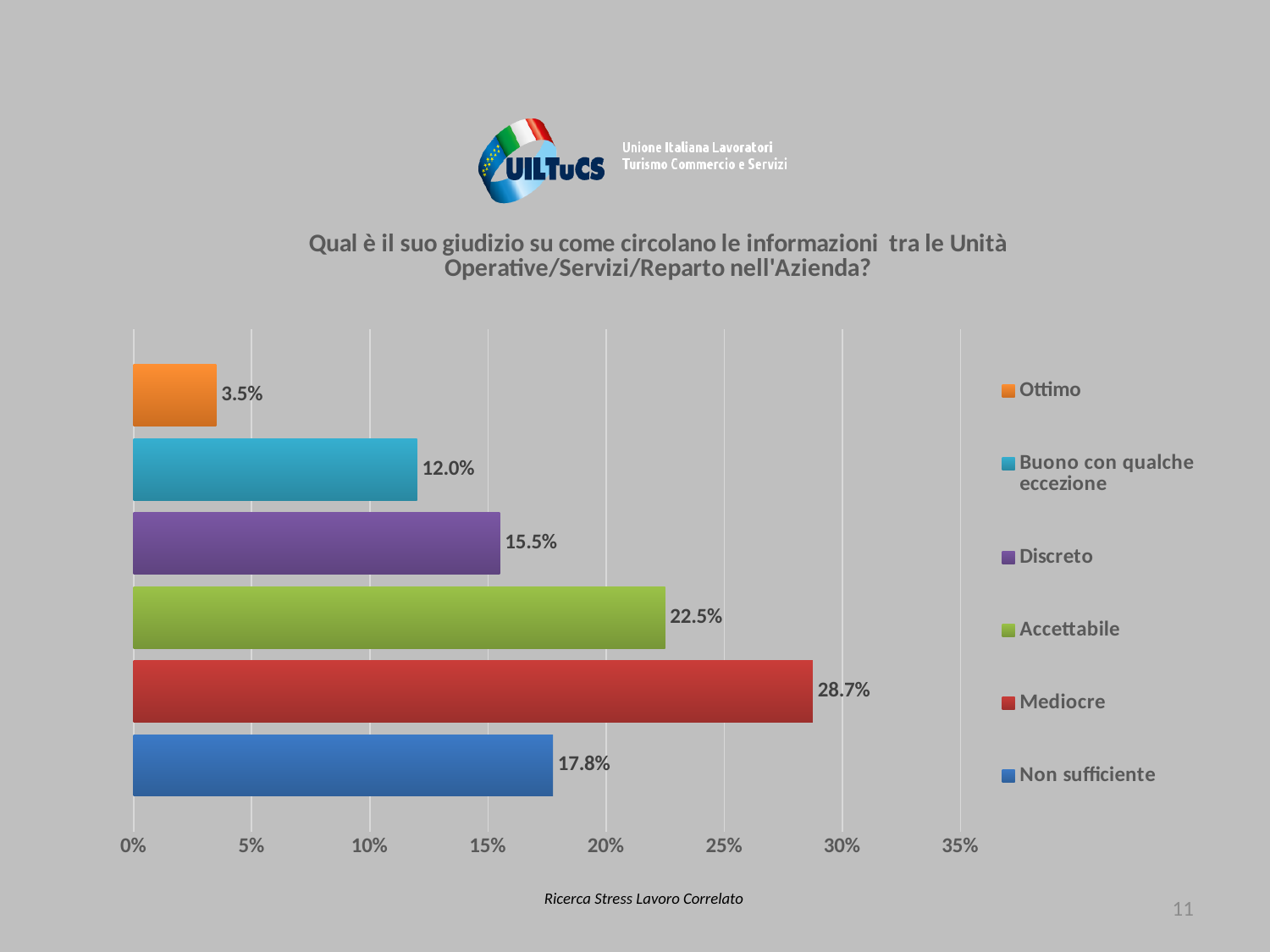
What is the value for Non sufficiente? 17.8% What is the value for Accettabile? 22.5% Which is larger, the value for Discreto or the value for Non sufficiente? Non sufficiente Is the value for Buono con qualche eccezione greater or less than 15%? less What kind of chart is shown on the slide? bar chart Which category has the lowest value? Ottimo Which category has the highest value? Mediocre What is the difference between the values for Mediocre and Accettabile? 6.2% How many categories are shown in the chart? 6 What colour is the bar for Discreto? purple What is the value for Ottimo? 3.5% What is the value for Mediocre? 28.7%